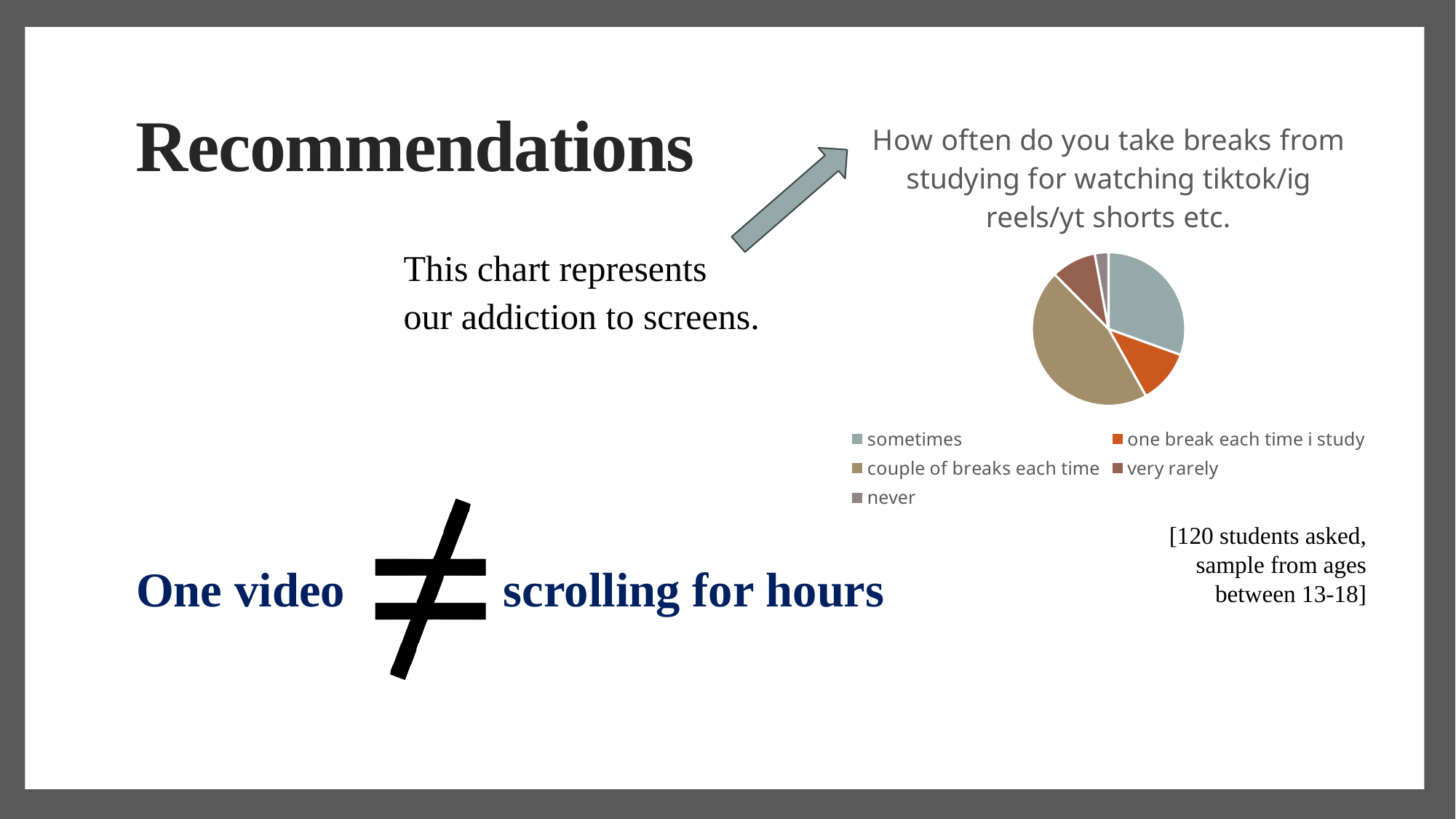
Which slice is larger: "couple of breaks each time" or "sometimes"? couple of breaks each time Which category has the largest slice of the pie chart? couple of breaks each time Which slice is larger: "very rarely" or "never"? very rarely What is the title of the pie chart? How often do you take breaks from studying for watching tiktok/ig reels/yt shorts etc. Which slice is larger: "sometimes" or "one break each time i study"? sometimes How many entries does the legend of the pie chart list? 5 How many categories (slices) does the pie chart have? 5 What kind of chart is shown on the slide? pie chart Which category is shown in orange in the pie chart? one break each time i study Which category has the smallest slice of the pie chart? never